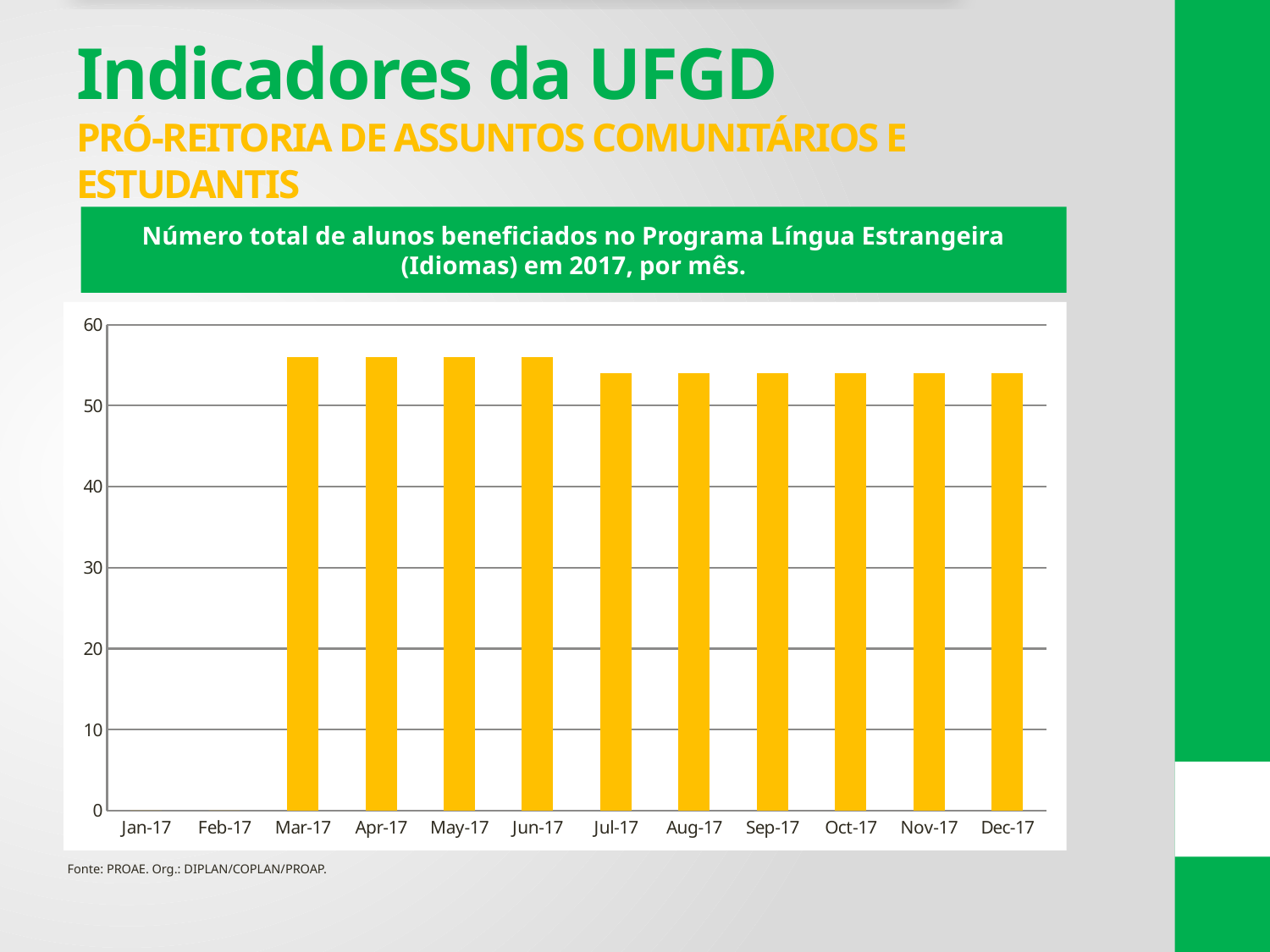
Which months on the x axis have no bar plotted? Jan-17 and Feb-17 From Mar-17 to Dec-17, do the values rise or fall overall? fall What is the title of the chart? Número total de alunos beneficiados no Programa Língua Estrangeira (Idiomas) em 2017, por mês. Is the value for Mar-17 greater or less than 50? greater Is the value for Jun-17 greater or less than 40? greater What is the highest value shown on the y axis of the chart? 60 Which is larger, the value for Jun-17 or the value for Jul-17? Jun-17 What kind of chart is shown on the slide? bar chart Which is larger, the value for Mar-17 or the value for Dec-17? Mar-17 Is the value for Dec-17 greater or less than 60? less How many months are listed along the x axis of the chart? 12